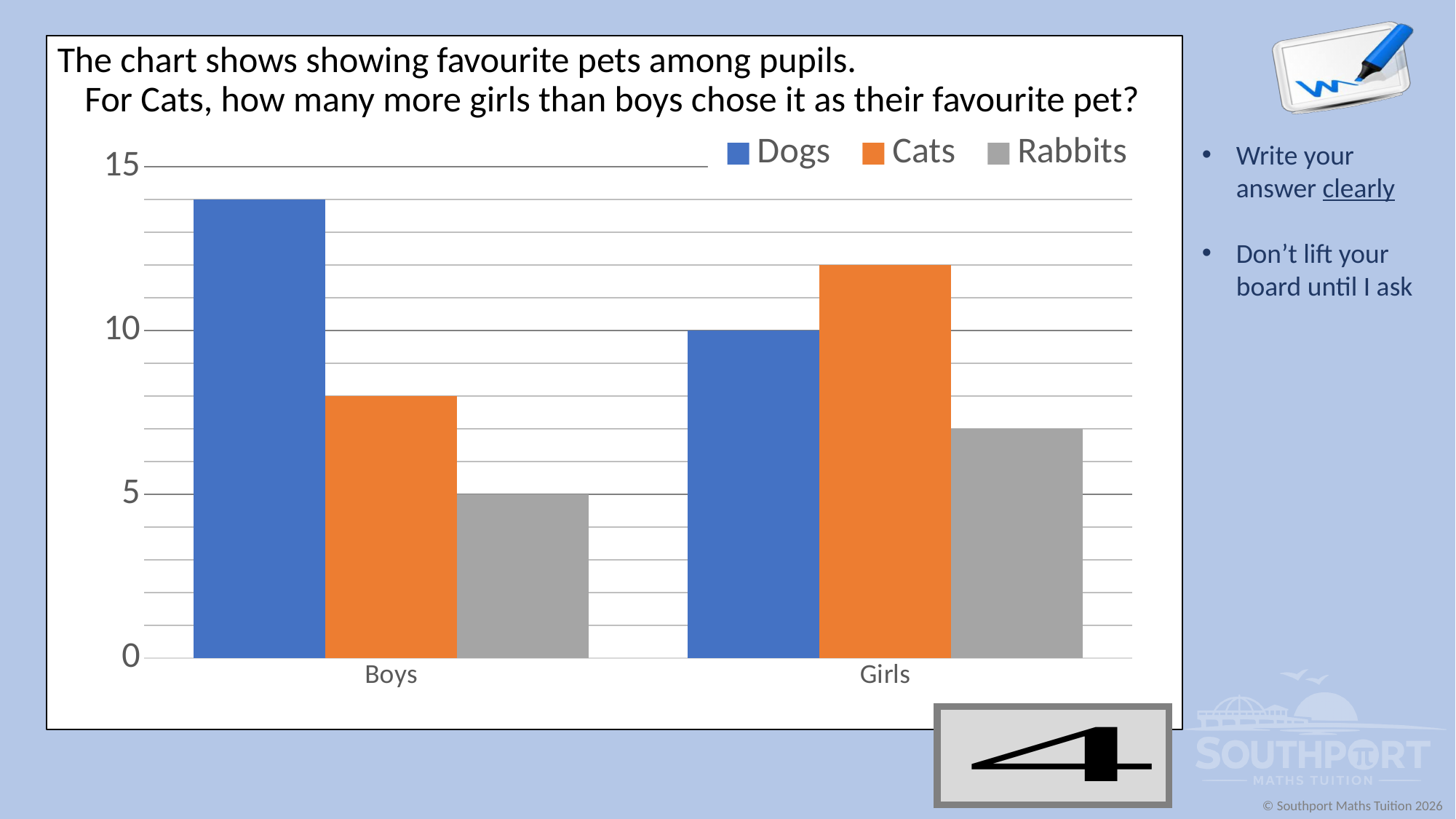
How many categories are shown on the x axis? 2 Which is larger, the Dogs value for Boys or the Dogs value for Girls? Boys What is the value for Dogs among Girls? 10 Which pet has the lowest value among Girls? Rabbits Is the value for Cats among Girls greater or less than 10? greater Is the value for Dogs among Boys greater or less than 10? greater What kind of chart is shown on the slide? bar chart Which pet has the highest value among Boys? Dogs Is the value for Cats among Boys greater or less than 10? less How many series does the legend list? 3 What is the value for Rabbits among Boys? 5 Which is larger, the Cats value for Boys or the Cats value for Girls? Girls